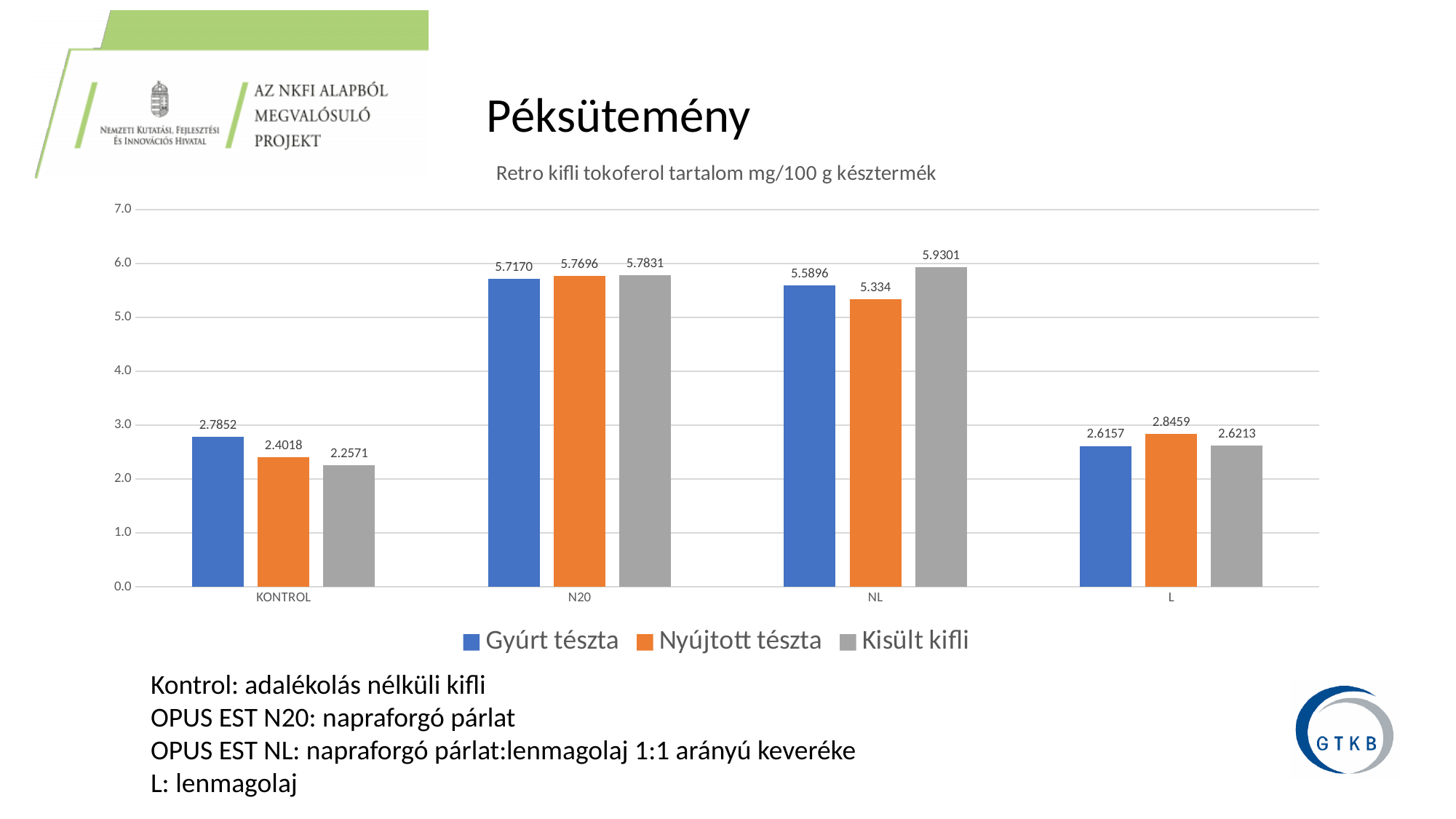
How many series does the legend list? 3 What is the value for Nyújtott tészta in the N20 category? 5.7696 What is the value for Nyújtott tészta in the L category? 2.8459 Which category has the highest value for Kisült kifli? NL What kind of chart is shown on the slide? Bar chart What is the value for Gyúrt tészta in the KONTROL category? 2.7852 What is the difference between the Kisült kifli value and the Nyújtott tészta value in the NL category? 0.5961 In the KONTROL category, which is larger: Gyúrt tészta or Kisült kifli? Gyúrt tészta Is the value for Gyúrt tészta in the NL category greater or less than 5.0? greater Which category has the lowest value for Gyúrt tészta? L How many categories are shown on the x axis? 4 What is the value for Kisült kifli in the NL category? 5.9301